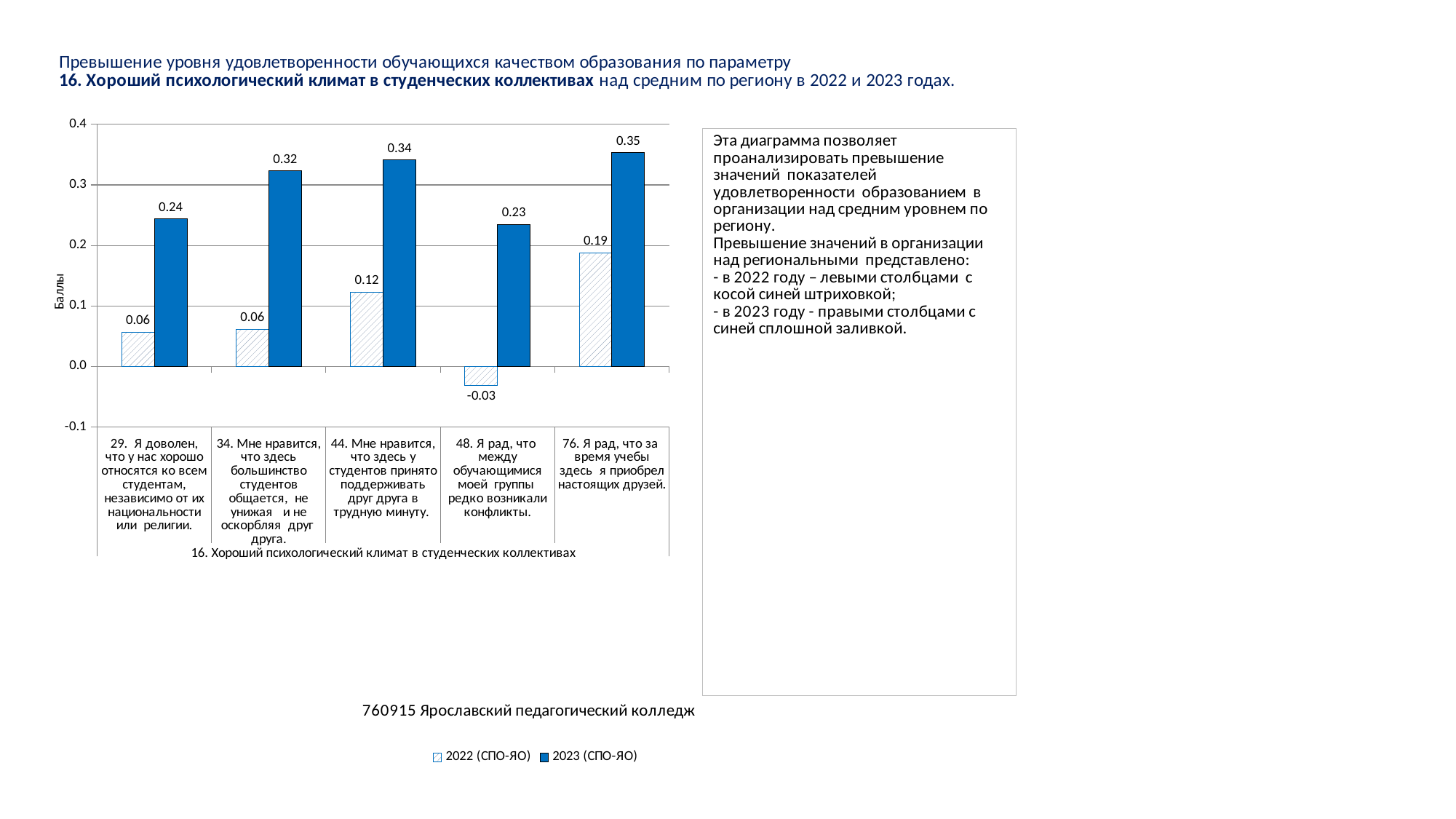
What is the value for 2023 (СПО-ЯО) for item 44 (Мне нравится, что здесь у студентов принято поддерживать друг друга в трудную минуту)? 0.34 How many series does the chart legend list? 2 What is the value for 2022 (СПО-ЯО) for item 48 (Я рад, что между обучающимися моей группы редко возникали конфликты)? -0.03 How many items (categories) are shown on the x axis of the chart? 5 Which item has the highest value for the 2023 (СПО-ЯО) series? 76. Я рад, что за время учебы здесь я приобрел настоящих друзей. Is the 2023 (СПО-ЯО) value for item 34 greater or less than 0.3? greater What is the difference between the 2023 (СПО-ЯО) and 2022 (СПО-ЯО) values for item 76? 0.16 Which item has the lowest value for the 2022 (СПО-ЯО) series? 48. Я рад, что между обучающимися моей группы редко возникали конфликты. What is the value for 2023 (СПО-ЯО) for item 29 (Я доволен, что у нас хорошо относятся ко всем студентам)? 0.24 What kind of chart is shown on the slide? Bar chart What is the difference between the 2023 (СПО-ЯО) and 2022 (СПО-ЯО) values for item 34? 0.26 For the 2022 (СПО-ЯО) series, which is larger: item 44 or item 29? Item 44